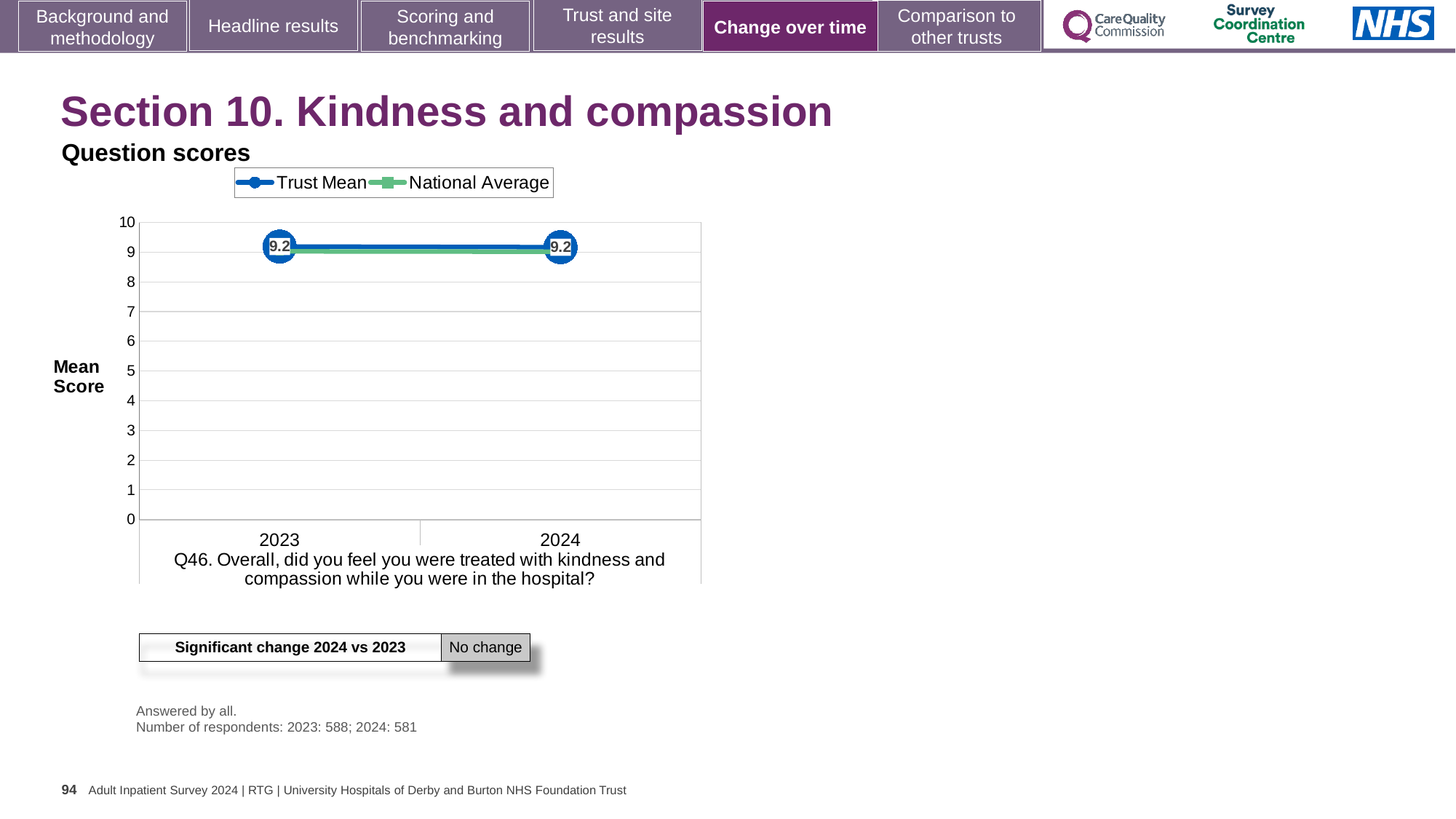
What are the two series named in the chart legend? Trust Mean and National Average Is the National Average value for 2024 greater or less than 8? greater What is the difference between the Trust Mean score in 2024 and in 2023? 0 How many years are shown on the x axis of the chart? 2 What is the Trust Mean score for 2023? 9.2 What is the label on the y axis of the chart? Mean Score What kind of chart is shown on the slide? Line chart Is the National Average value for 2023 greater or less than 5? greater What is the Trust Mean score for 2024? 9.2 How many series does the chart legend list? 2 Does the Trust Mean rise, fall or stay the same from 2023 to 2024? Stays the same